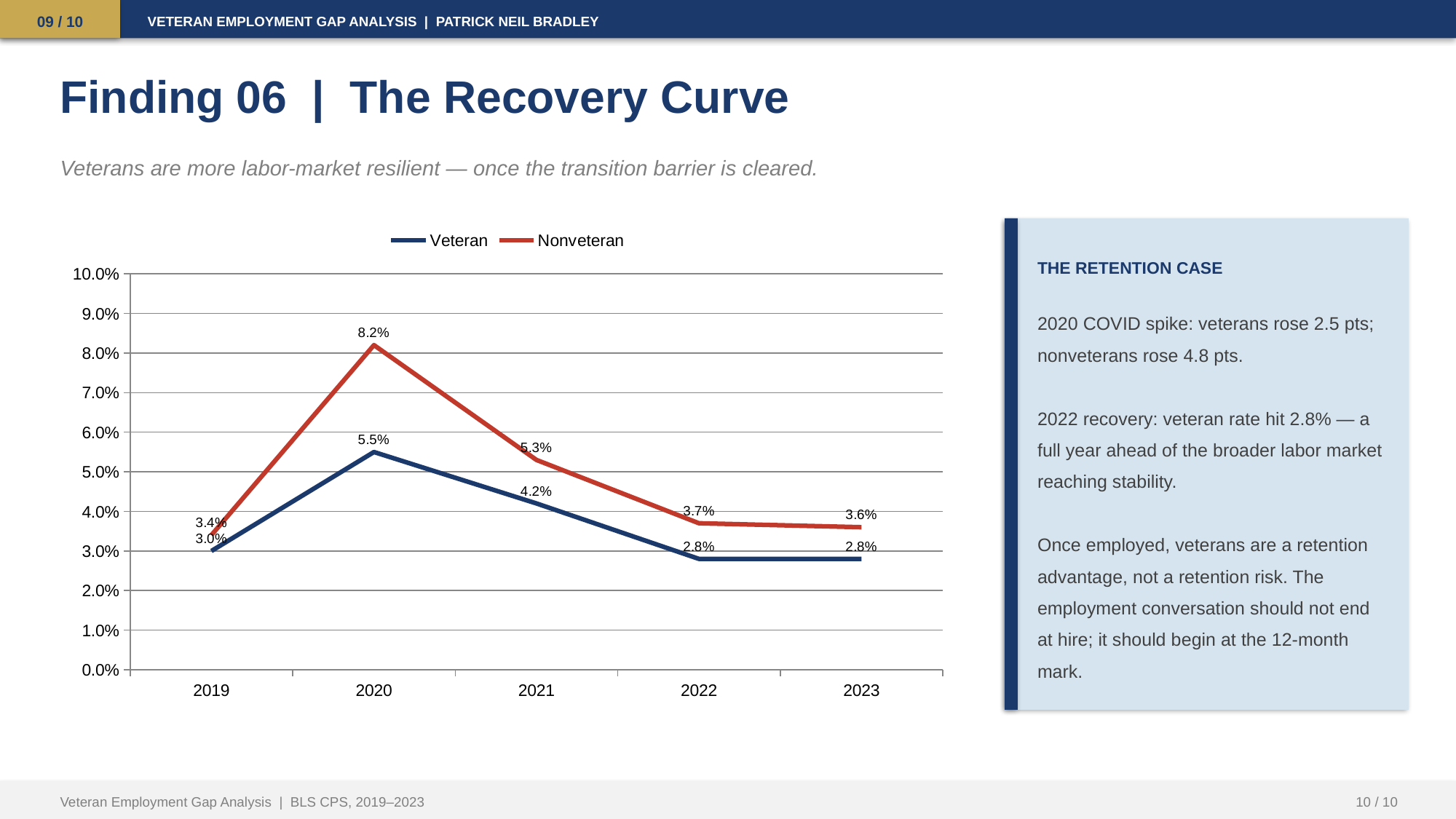
In which year is the Veteran series lowest? 2022 and 2023 How many years are shown on the x axis? 5 Does the Veteran series rise or fall from 2020 to 2022? Fall Is the Nonveteran value for 2020 greater or less than 8.0%? greater In which year is the Nonveteran series highest? 2020 What is the Veteran value for 2020? 5.5% How many series does the legend list? 2 What is the difference between the Nonveteran and Veteran values in 2020? 2.7% What is the Veteran value for 2023? 2.8% What is the Nonveteran value for 2021? 5.3% Which series has the larger value in 2022, Veteran or Nonveteran? Nonveteran What kind of chart is shown on the slide? Line chart